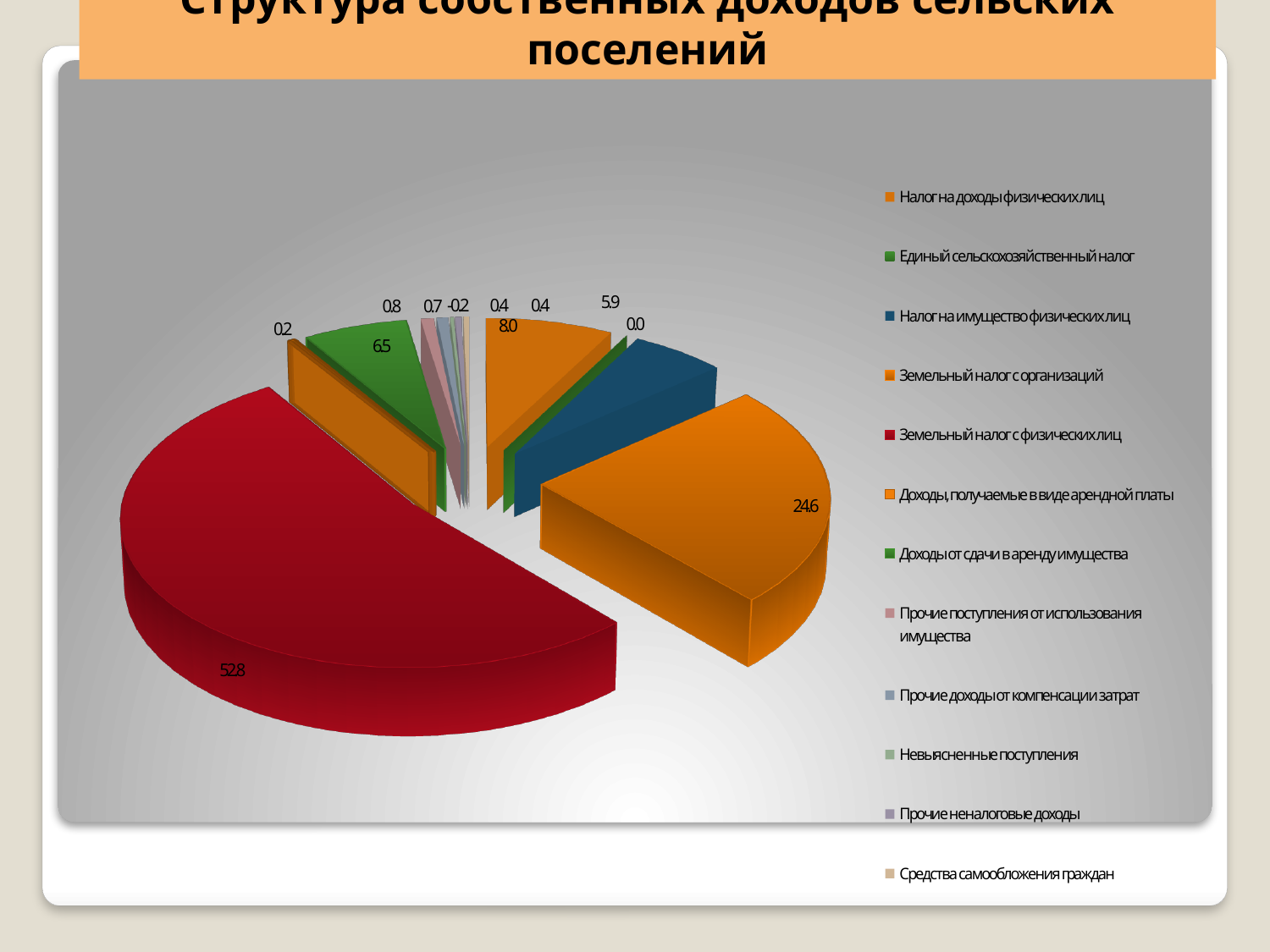
What is the difference between the values for Земельный налог с физических лиц and Земельный налог с организаций? 28.2 What is the value shown for Налог на имущество физических лиц? 5.9 What is the value shown for Налог на доходы физических лиц? 8.0 Which is larger: the value for Доходы от сдачи в аренду имущества or the value for Налог на имущество физических лиц? Доходы от сдачи в аренду имущества What is the value shown for Доходы от сдачи в аренду имущества? 6.5 What is the value shown for Земельный налог с физических лиц? 52.8 What is the title of the chart? Структура собственных доходов сельских поселений How many categories does the legend list? 12 What kind of chart is shown on the slide? pie chart Which category has the largest slice of the pie? Земельный налог с физических лиц What colour is the slice for Земельный налог с физических лиц? red What is the value shown for Земельный налог с организаций? 24.6